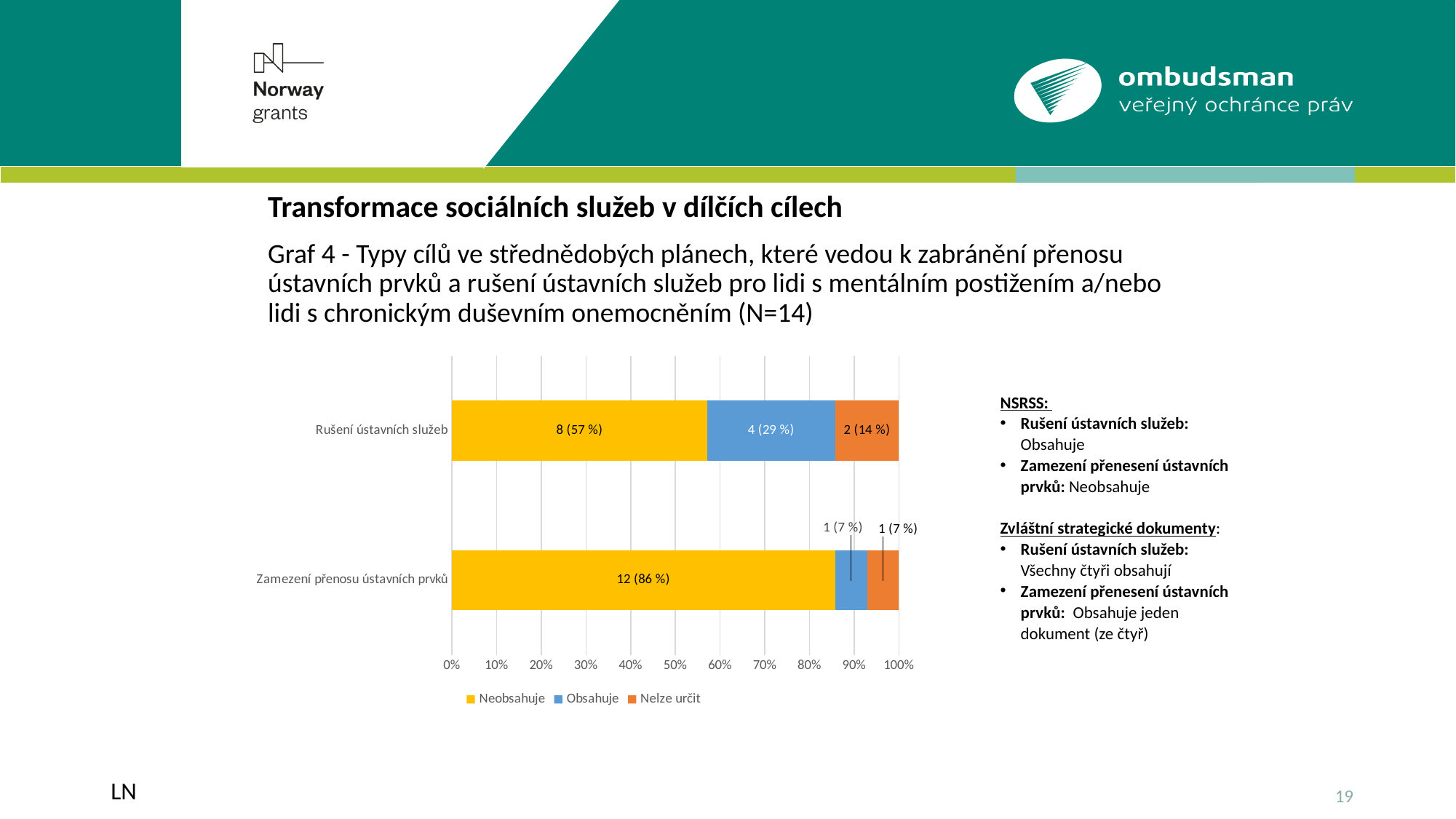
What is the difference in the 'Neobsahuje' count between 'Zamezení přenosu ústavních prvků' and 'Rušení ústavních služeb'? 4 What is the value of 'Neobsahuje' for 'Rušení ústavních služeb'? 8 (57 %) How many series does the chart legend list? 3 What is the value of 'Obsahuje' for 'Rušení ústavních služeb'? 4 (29 %) What is the value of 'Nelze určit' for 'Rušení ústavních služeb'? 2 (14 %) How many categories are plotted on the chart? 2 Which legend entry is shown in orange? Nelze určit Is the 'Obsahuje' count larger for 'Rušení ústavních služeb' or for 'Zamezení přenosu ústavních prvků'? Rušení ústavních služeb What is the value of 'Obsahuje' for 'Zamezení přenosu ústavních prvků'? 1 (7 %) What kind of chart is shown on the slide? Stacked bar chart Which category has the higher 'Neobsahuje' count? Zamezení přenosu ústavních prvků What is the value of 'Neobsahuje' for 'Zamezení přenosu ústavních prvků'? 12 (86 %)